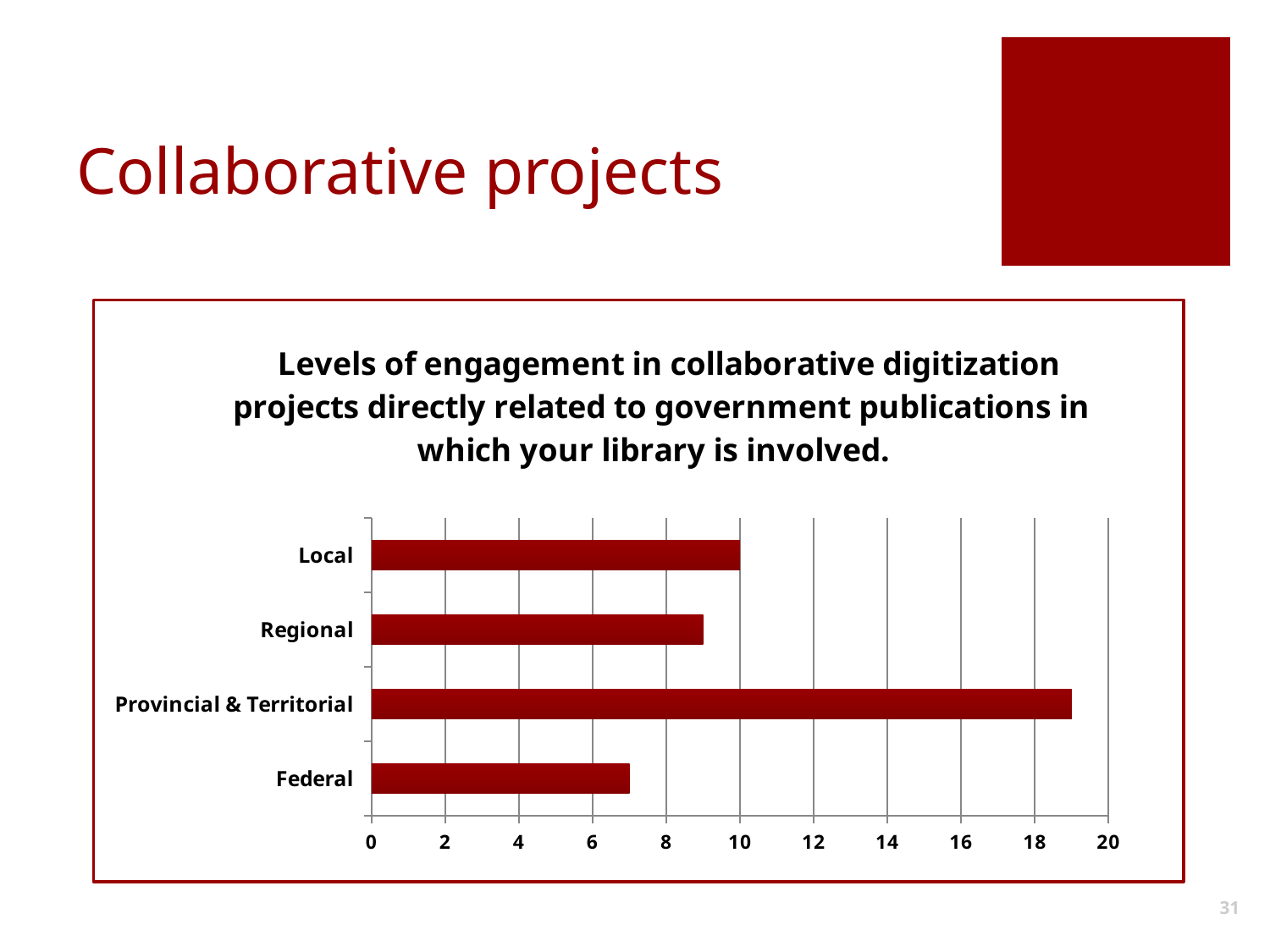
Which category has the lowest value? Federal What is the value for Local? 10 What kind of chart is shown on the slide? bar chart What is the maximum value shown on the horizontal axis of the chart? 20 Is the value for Regional greater or less than 8? greater Is the value for Federal greater or less than 8? less Which category has the highest value? Provincial & Territorial Which is larger, the value for Regional or the value for Provincial & Territorial? Provincial & Territorial Is the value for Provincial & Territorial greater or less than 20? less Which is larger, the value for Local or the value for Federal? Local How many categories are shown in the chart? 4